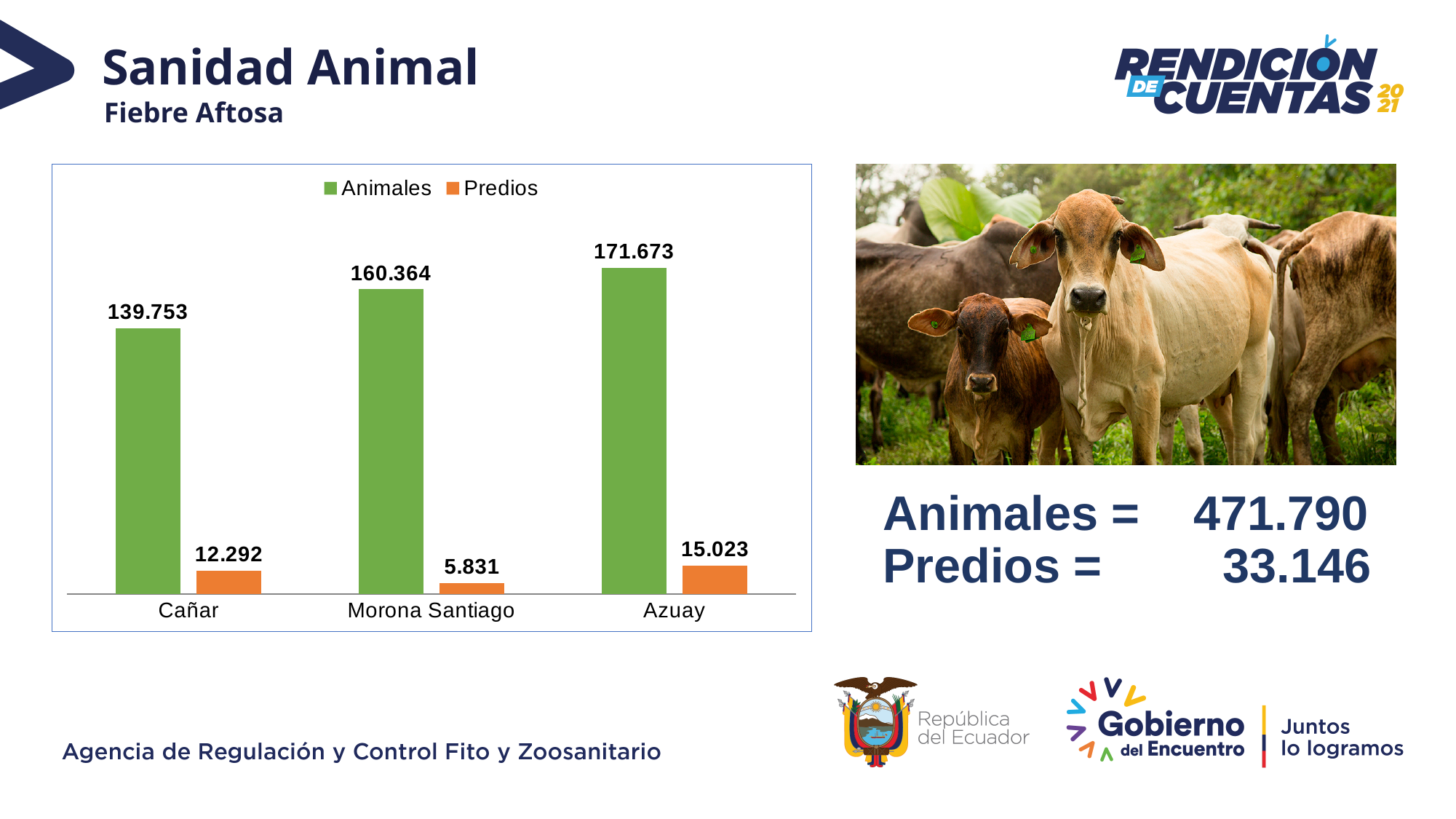
What is the Animales value for Morona Santiago? 160.364 Which province has the lowest Predios value? Morona Santiago What is the Animales value for Azuay? 171.673 What kind of chart is shown on the slide? Bar chart Which province has the highest Animales value? Azuay What is the difference between the Predios values for Azuay and Morona Santiago? 9.192 How many series does the chart legend list? 2 What is the difference between the Animales values for Azuay and Cañar? 31.920 Do the Animales values rise or fall from Cañar to Azuay along the x axis? Rise Which is larger, the Predios value for Cañar or for Azuay? Azuay What is the Predios value for Cañar? 12.292 How many provinces are shown on the x axis of the chart? 3